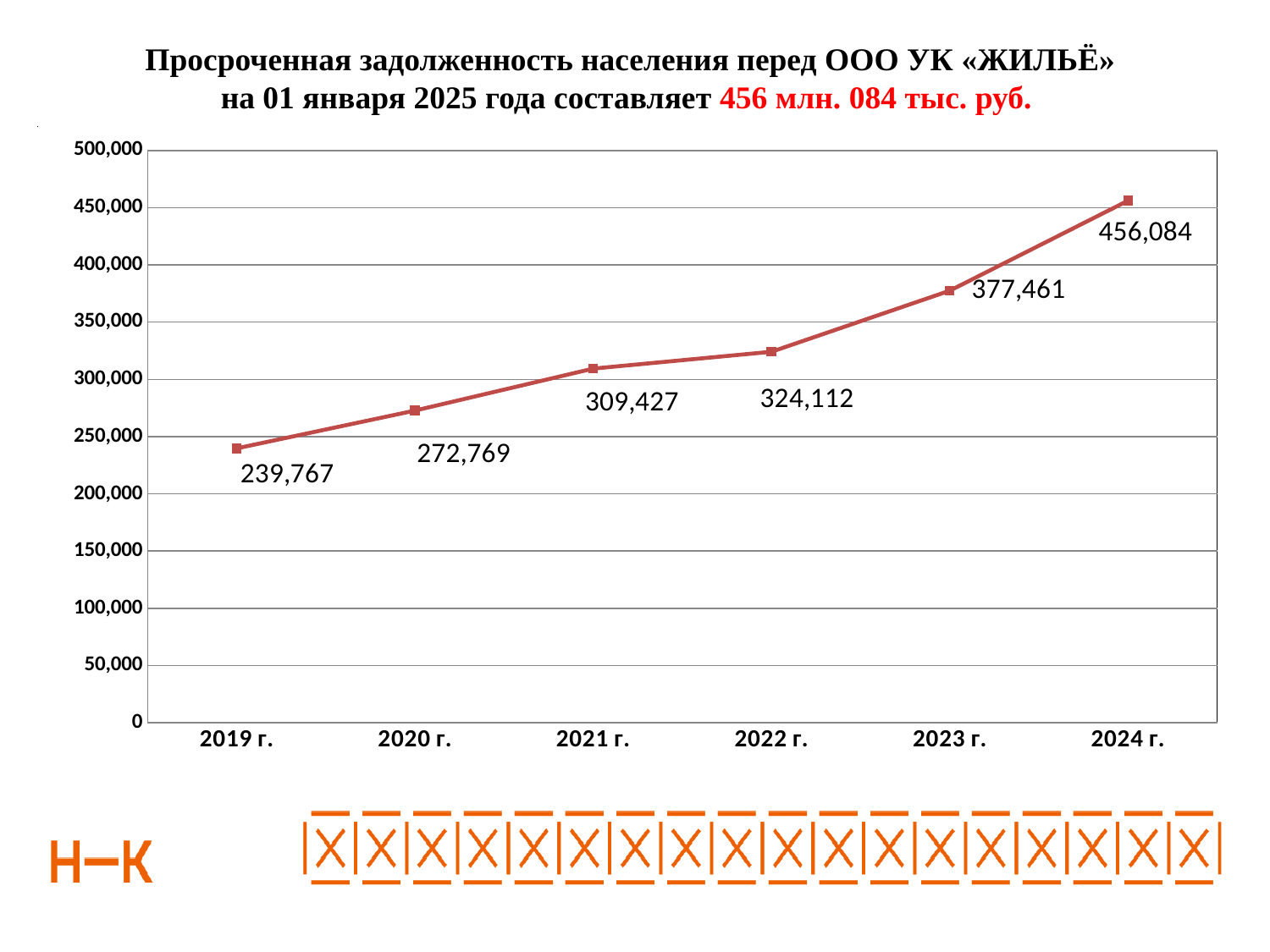
What is the value for 2019 г.? 239,767 Is the value for 2023 г. greater or less than 350,000? greater What kind of chart is shown on the slide? line chart Which year has the highest value? 2024 г. What is the difference between the values for 2020 г. and 2019 г.? 33,002 How many years are plotted on the chart? 6 Which is larger, the value for 2022 г. or the value for 2021 г.? 2022 г. What is the difference between the values for 2024 г. and 2023 г.? 78,623 What is the value for 2021 г.? 309,427 What is the value for 2024 г.? 456,084 Do the values rise or fall from 2019 г. to 2024 г.? rise Which year has the lowest value? 2019 г.